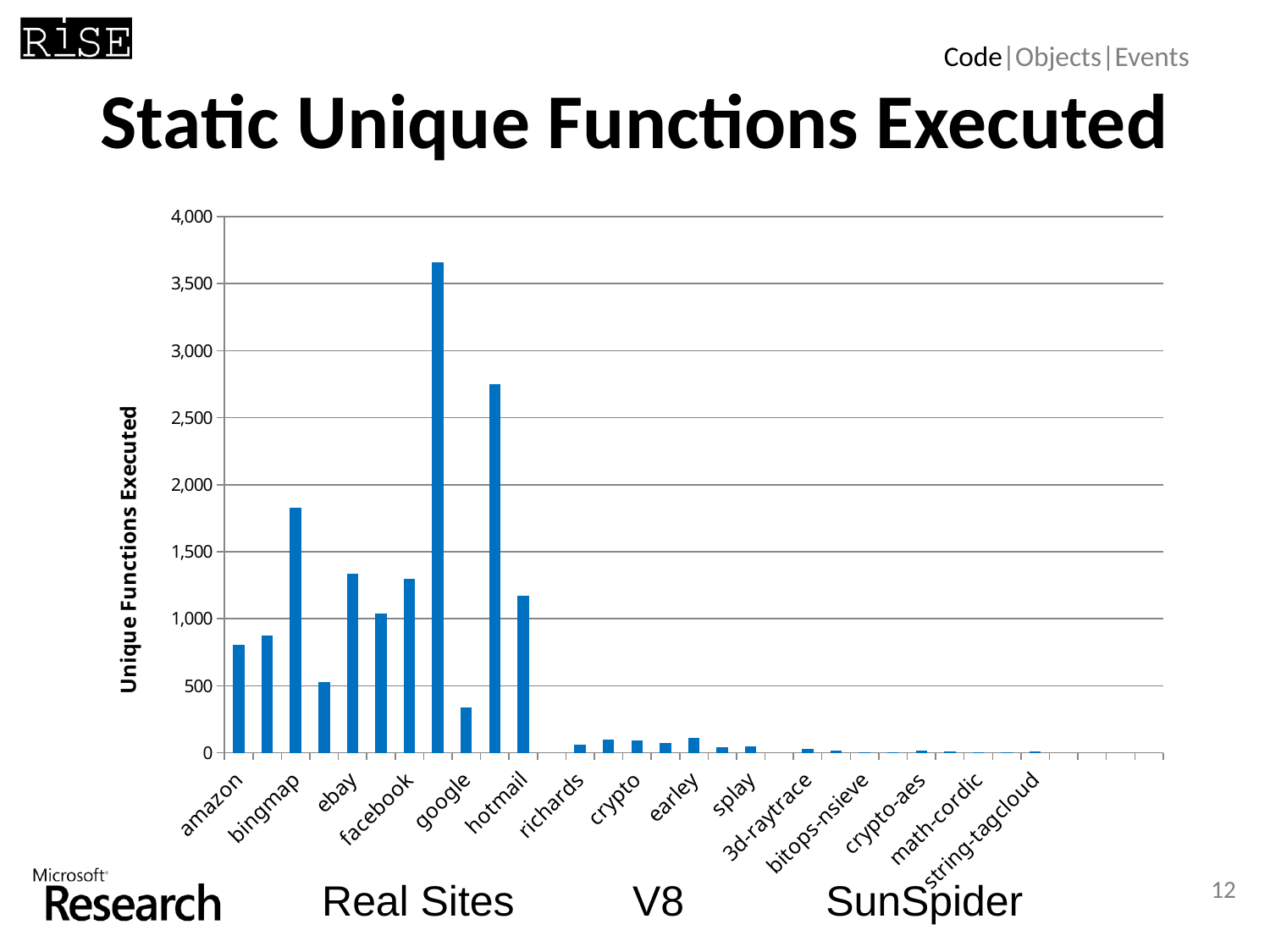
Is the value for hotmail greater or less than 1,000? greater Is the value for richards greater or less than 500? less Is the value for amazon greater or less than 1,000? less Which has a higher value, amazon or google? amazon Moving from the Real Sites group to the SunSpider group along the x axis, do the bar values generally rise or fall? fall What is the title of the chart on the slide? Static Unique Functions Executed What kind of chart is shown on the slide? bar chart Which has a higher value, bingmap or ebay? bingmap What is the label on the vertical axis of the chart? Unique Functions Executed